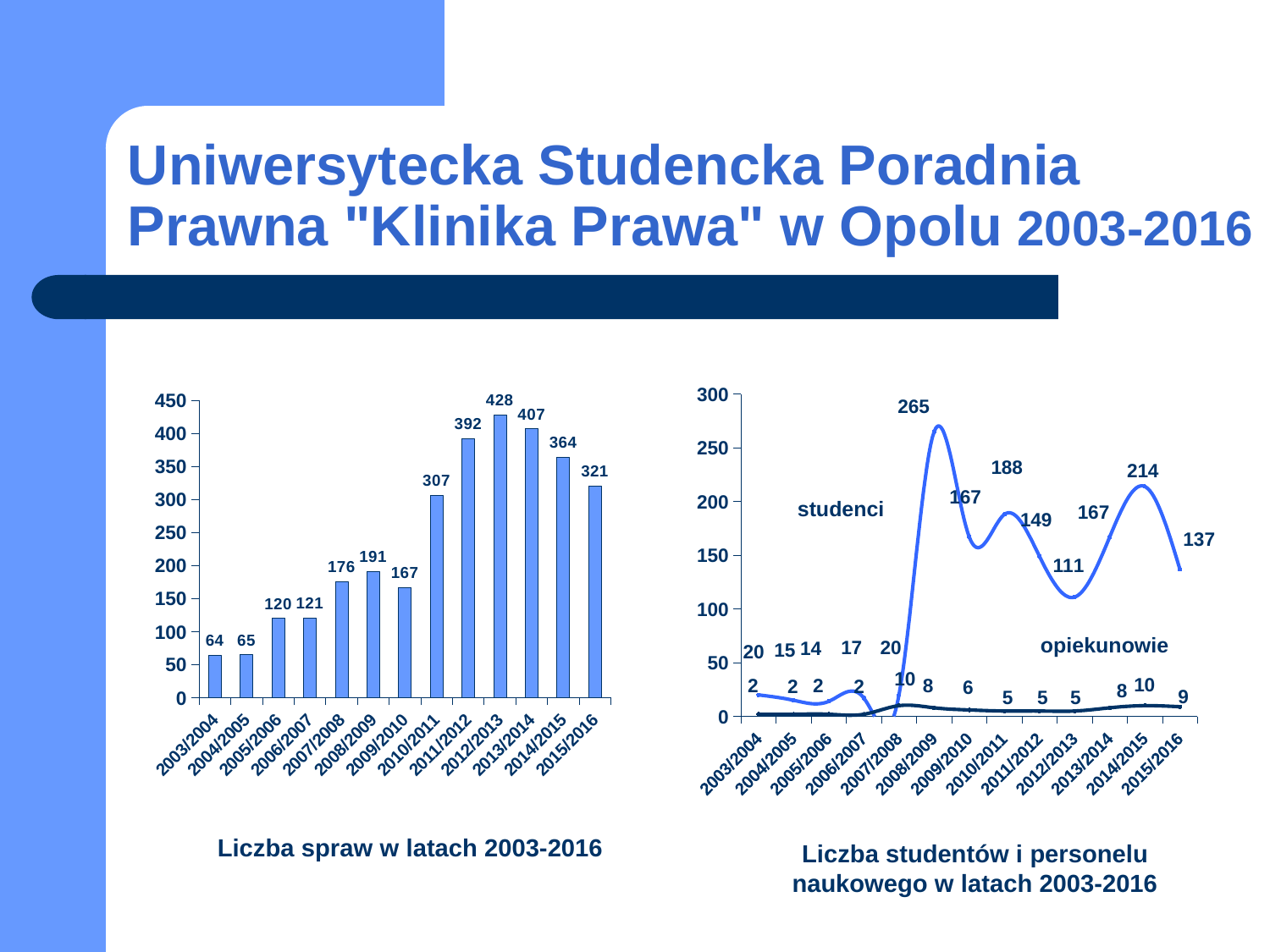
In the chart 'Liczba spraw w latach 2003-2016', which year has the lowest value? 2003/2004 In the chart 'Liczba studentów i personelu naukowego w latach 2003-2016', which is larger in 2014/2015: studenci or opiekunowie? studenci What kind of chart is 'Liczba studentów i personelu naukowego w latach 2003-2016'? line chart In the chart 'Liczba studentów i personelu naukowego w latach 2003-2016', what is the value for opiekunowie in 2015/2016? 9 In the chart 'Liczba spraw w latach 2003-2016', what is the difference between the values for 2011/2012 and 2010/2011? 85 In the chart 'Liczba spraw w latach 2003-2016', which year has the highest value? 2012/2013 In the chart 'Liczba spraw w latach 2003-2016', what is the value for 2012/2013? 428 In the chart 'Liczba spraw w latach 2003-2016', what is the value for 2007/2008? 176 In the chart 'Liczba studentów i personelu naukowego w latach 2003-2016', what is the difference between studenci in 2014/2015 and studenci in 2015/2016? 77 What kind of chart is 'Liczba spraw w latach 2003-2016'? bar chart In the chart 'Liczba spraw w latach 2003-2016', how many years are shown on the x axis? 13 In the chart 'Liczba studentów i personelu naukowego w latach 2003-2016', what is the value for studenci in 2008/2009? 265